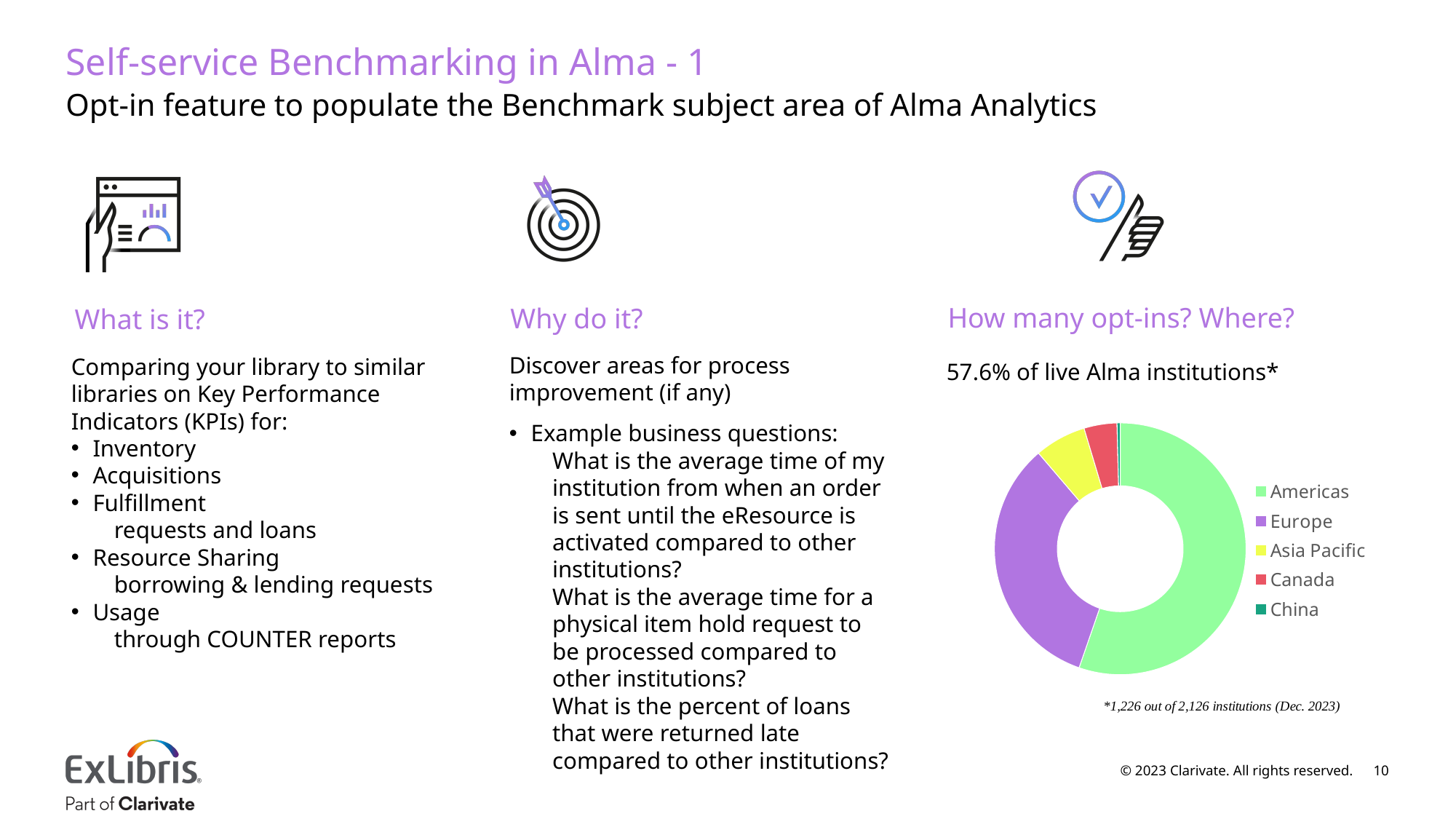
In the pie chart, which slice is larger, Europe or Canada? Europe How many regions does the legend of the pie chart list? 5 In the pie chart, which slice is larger, Americas or Europe? Americas Which region is shown in yellow in the pie chart? Asia Pacific Which region has the largest slice in the pie chart? Americas In the pie chart, which slice is larger, Europe or Asia Pacific? Europe According to the text above the pie chart, what percentage of live Alma institutions have opted in? 57.6% Which region has the second-largest slice in the pie chart? Europe What kind of chart is shown under "How many opt-ins? Where?"? doughnut chart Which region has the smallest slice in the pie chart? China What colour represents Europe in the pie chart? purple